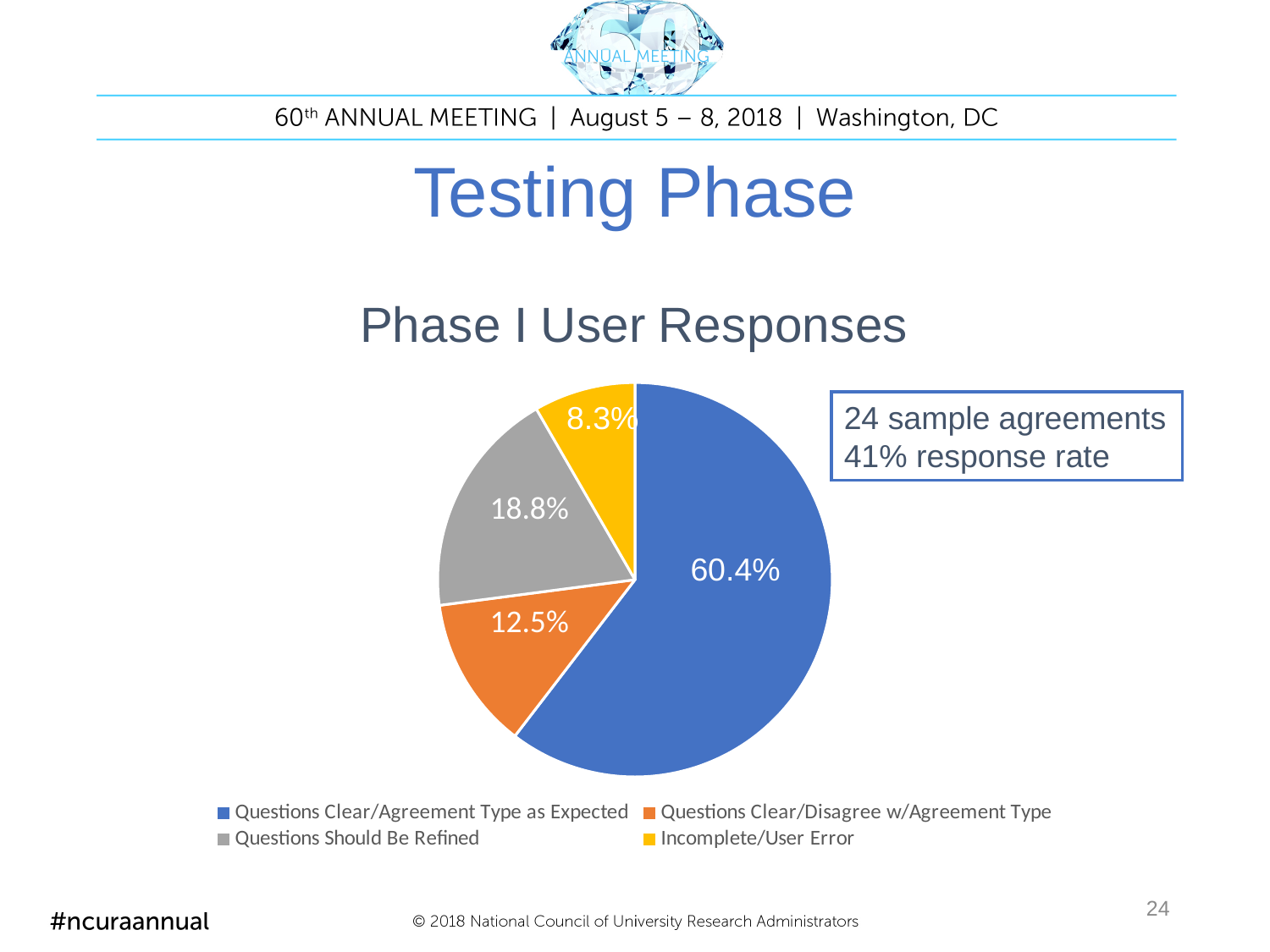
How many categories does the pie chart show? 4 What percentage of responses were 'Questions Clear/Disagree w/Agreement Type'? 12.5% Which is larger: the share for 'Questions Should Be Refined' or the share for 'Questions Clear/Disagree w/Agreement Type'? Questions Should Be Refined What is the title of the chart? Phase I User Responses What colour is the slice for 'Incomplete/User Error'? yellow What percentage of responses were 'Questions Clear/Agreement Type as Expected'? 60.4% What is the difference in percentage points between 'Questions Clear/Agreement Type as Expected' and 'Questions Should Be Refined'? 41.6 Which category has the smallest share of the pie? Incomplete/User Error What type of chart is shown on the slide? pie chart Which category has the largest share of the pie? Questions Clear/Agreement Type as Expected What percentage of responses were 'Questions Should Be Refined'? 18.8% What percentage of responses were 'Incomplete/User Error'? 8.3%